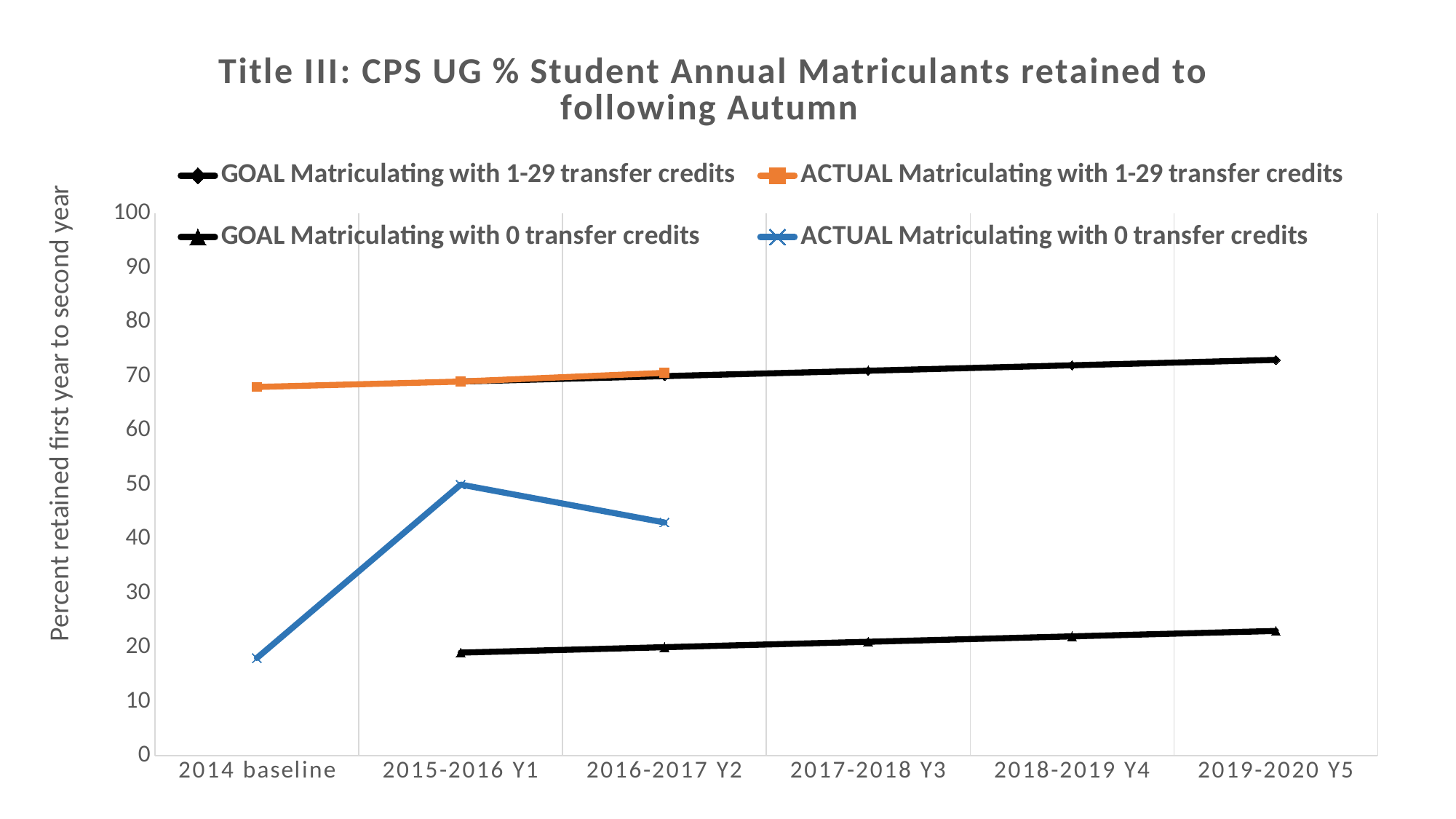
Is the value for ACTUAL Matriculating with 0 transfer credits at 2014 baseline greater or less than 30? less What is the title of the y axis? Percent retained first year to second year Does the GOAL Matriculating with 1-29 transfer credits line rise or fall from 2014 baseline to 2019-2020 Y5? rise Is the value for ACTUAL Matriculating with 0 transfer credits at 2016-2017 Y2 greater or less than 50? less At 2016-2017 Y2, which is higher: ACTUAL Matriculating with 0 transfer credits or GOAL Matriculating with 0 transfer credits? ACTUAL Matriculating with 0 transfer credits In which year is the ACTUAL Matriculating with 0 transfer credits value lowest? 2014 baseline How many categories are shown on the x axis? 6 Is the value for ACTUAL Matriculating with 0 transfer credits at 2015-2016 Y1 greater or less than 40? greater How many series does the legend list? 4 In which year is the ACTUAL Matriculating with 0 transfer credits value highest? 2015-2016 Y1 What kind of chart is shown on the slide? line chart